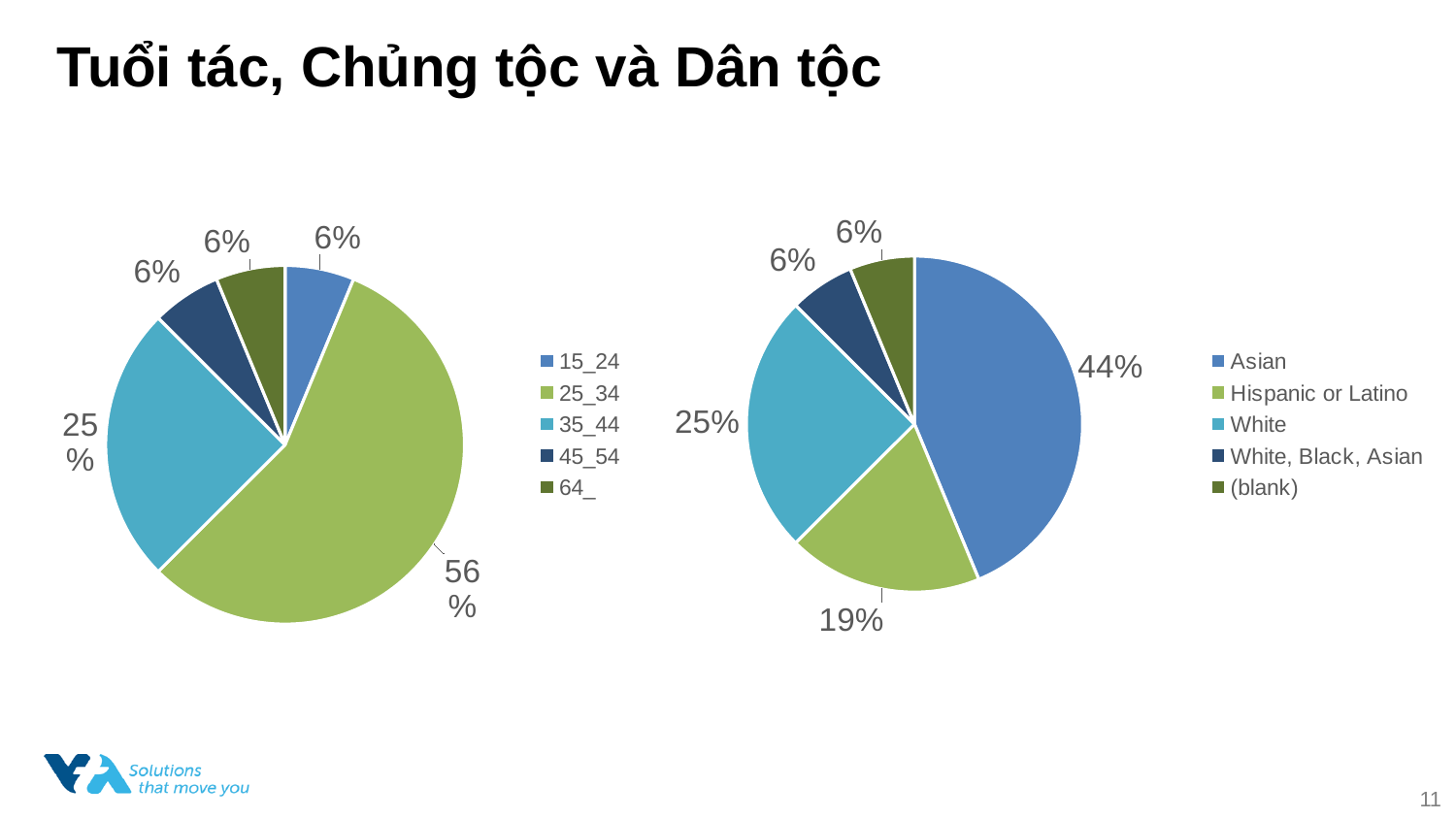
In the left pie chart, which category has the largest slice? 25_34 In the left pie chart, what is the difference between the 25_34 share and the 35_44 share? 31% In the left pie chart, what share does the 25_34 slice have? 56% In the right pie chart, what share does the Hispanic or Latino slice have? 19% In the right pie chart, which is larger, the White slice or the Hispanic or Latino slice? White In the right pie chart, what share does the Asian slice have? 44% How many entries does the legend of the right pie chart list? 5 In the left pie chart, what share does the 35_44 slice have? 25% In the right pie chart, which category has the largest slice? Asian In the right pie chart, what is the difference between the Asian share and the White share? 19% How many slices does the left pie chart have? 5 What kind of chart is the left chart on the slide? pie chart